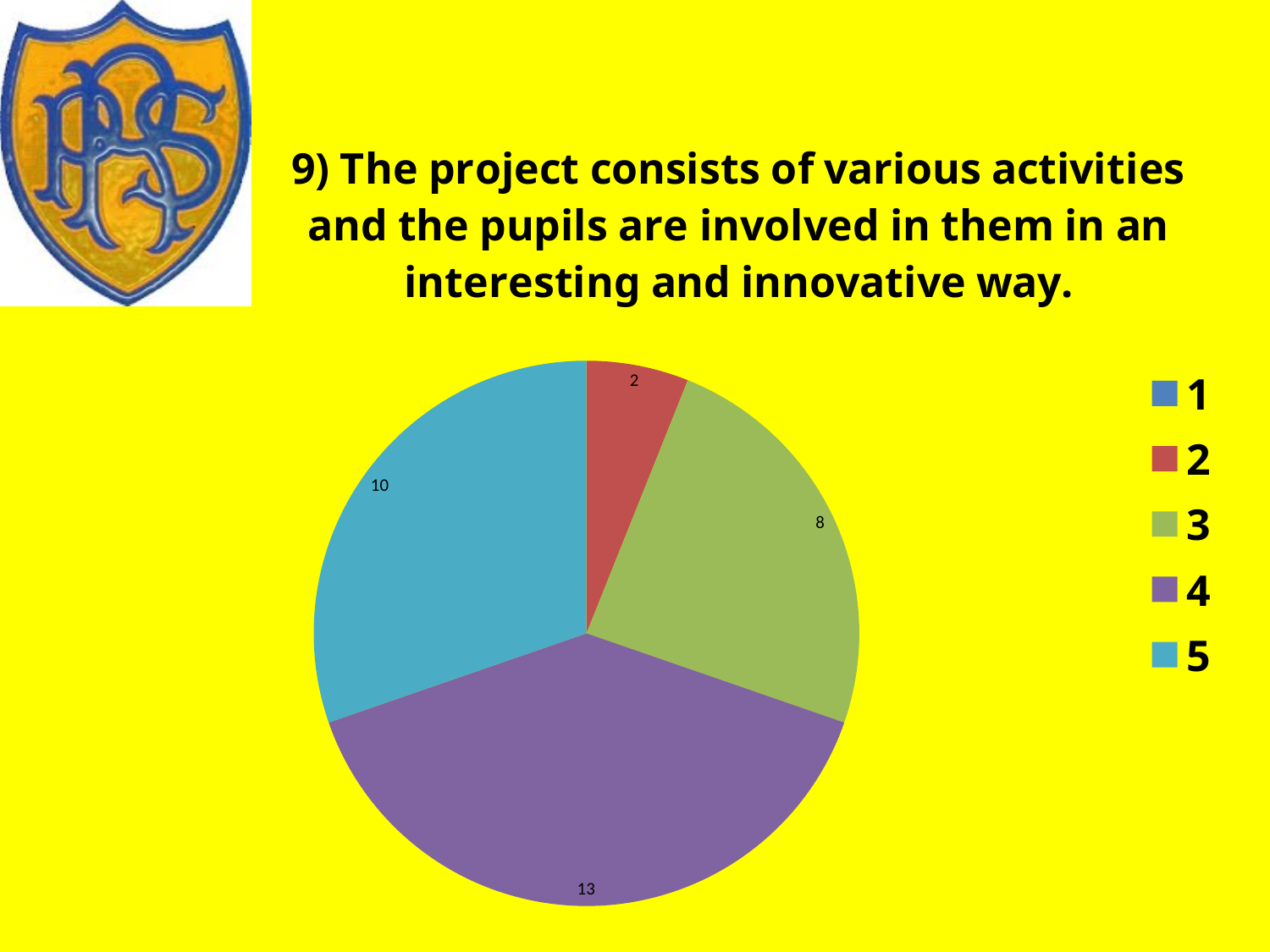
Which category has the largest slice in the pie chart? 4 What value is shown for category 3 in the pie chart? 8 What value is shown for category 4 in the pie chart? 13 Which labelled category has the smallest slice in the pie chart? 2 What kind of chart is shown on the slide? pie chart Which is larger, the value for category 3 or the value for category 5? 5 How many entries does the legend list? 5 What value is shown for category 5 in the pie chart? 10 What colour is the slice for category 4? purple What value is shown for category 2 in the pie chart? 2 What is the difference between the values for category 4 and category 5? 3 What is the difference between the values for category 3 and category 2? 6